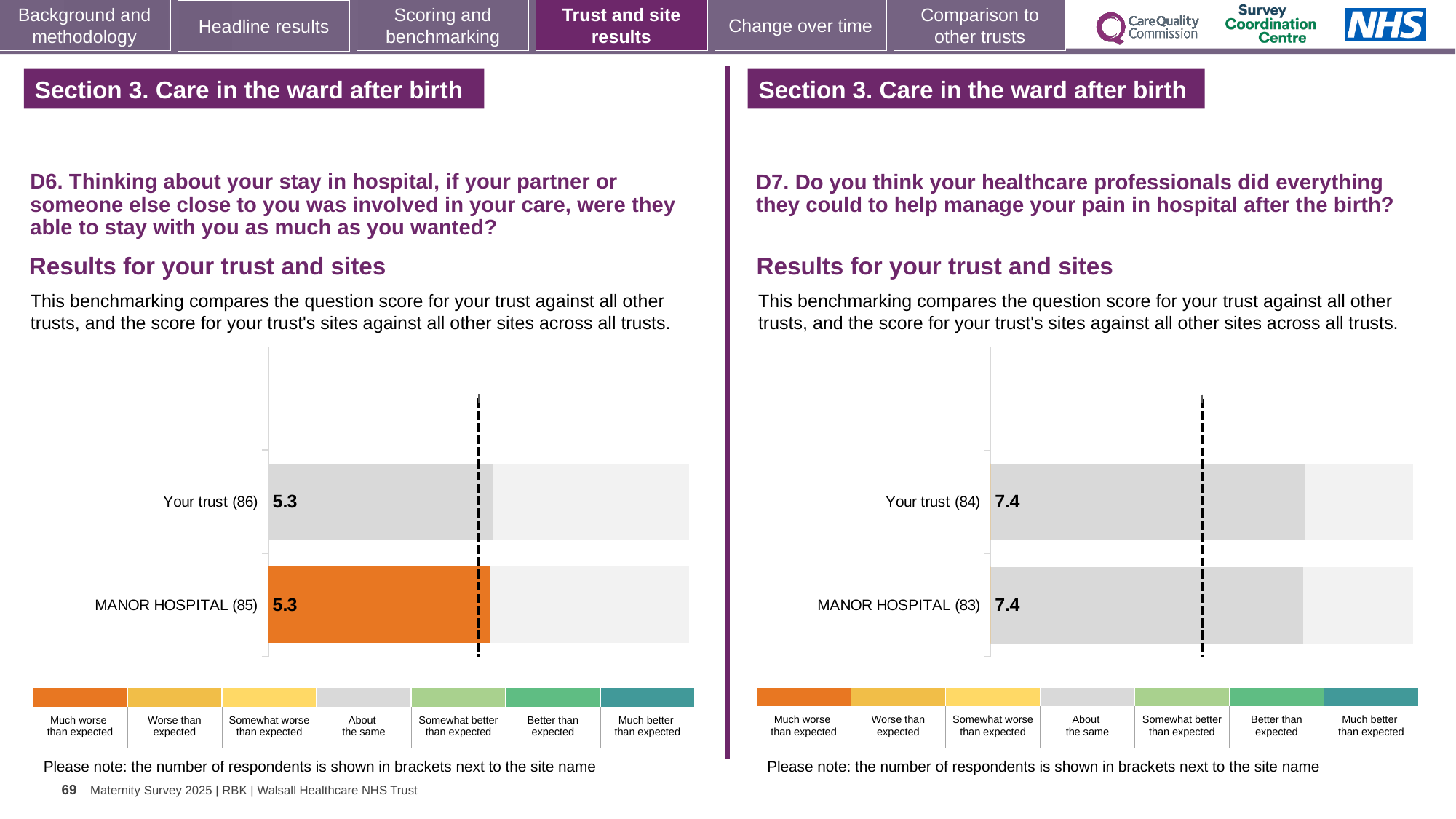
On the D6 chart (left), how many respondents are shown in brackets for MANOR HOSPITAL? 85 On the D7 chart (right), what is the score for Your trust? 7.4 On the D7 chart (right), how many respondents are shown in brackets for Your trust? 84 On the D7 chart (right), which benchmark category does the colour of the Your trust bar correspond to? About the same What kind of chart is the D7 chart (right)? Bar chart On the D6 chart (left), what is the score for MANOR HOSPITAL? 5.3 On the D7 chart (right), what is the difference between the MANOR HOSPITAL score and the Your trust score? 0.0 On the D6 chart (left), what is the score for Your trust? 5.3 How many bars are plotted on the D6 chart (left)? 2 On the D6 chart (left), which benchmark category does the colour of the MANOR HOSPITAL bar correspond to? Much worse than expected On the D6 chart (left), what is the difference between the Your trust score and the MANOR HOSPITAL score? 0.0 On the D7 chart (right), what is the score for MANOR HOSPITAL? 7.4